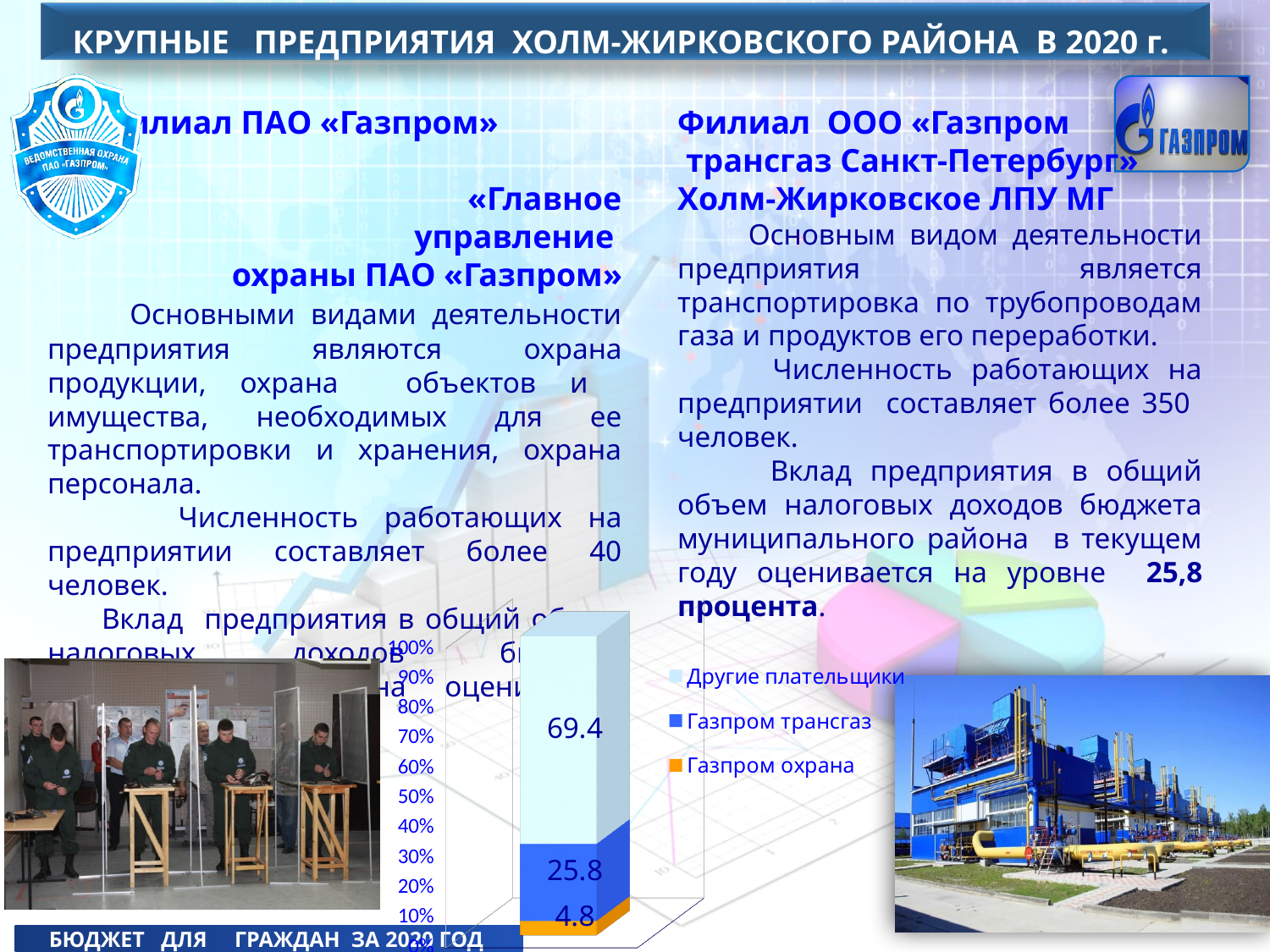
What is the highest tick value shown on the chart's vertical axis? 100% Which is larger in the chart: the value for "Газпром трансгаз" or the value for "Газпром охрана"? Газпром трансгаз What is the total of the three segments in the stacked bar? 100 How many series does the chart legend list? 3 Which segment of the stacked bar has the largest value? Другие плательщики What type of chart is shown on the slide? Stacked bar chart What value is shown for the "Газпром трансгаз" segment in the stacked bar chart? 25.8 What value is shown for the "Газпром охрана" segment in the stacked bar chart? 4.8 What is the difference between the "Другие плательщики" value and the "Газпром трансгаз" value in the chart? 43.6 What value is shown for the "Другие плательщики" segment in the stacked bar chart? 69.4 What is the difference between the "Газпром трансгаз" value and the "Газпром охрана" value in the chart? 21.0 Which segment of the stacked bar has the smallest value? Газпром охрана